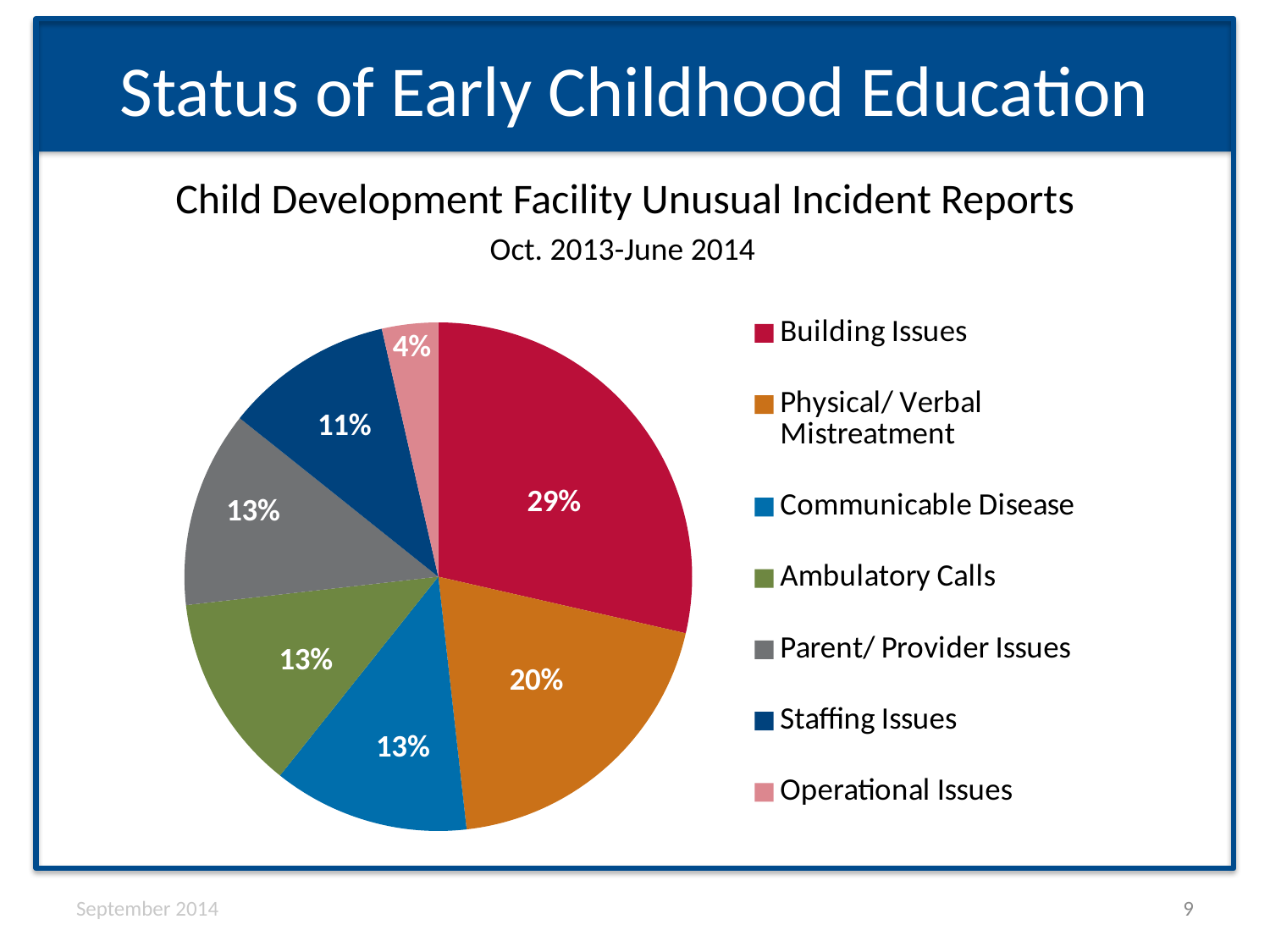
What share of the unusual incident reports is Staffing Issues? 11% What time period does the chart subtitle cover? Oct. 2013-June 2014 What share of the unusual incident reports is Building Issues? 29% What share of the unusual incident reports is Physical/ Verbal Mistreatment? 20% What is the title of the chart? Child Development Facility Unusual Incident Reports Which category has the largest share of the pie? Building Issues Which category has the smallest share of the pie? Operational Issues What is the difference in percentage points between Building Issues and Physical/ Verbal Mistreatment? 9 Which is larger, the share for Staffing Issues or the share for Communicable Disease? Communicable Disease What kind of chart is shown on the slide? pie chart How many categories does the legend list? 7